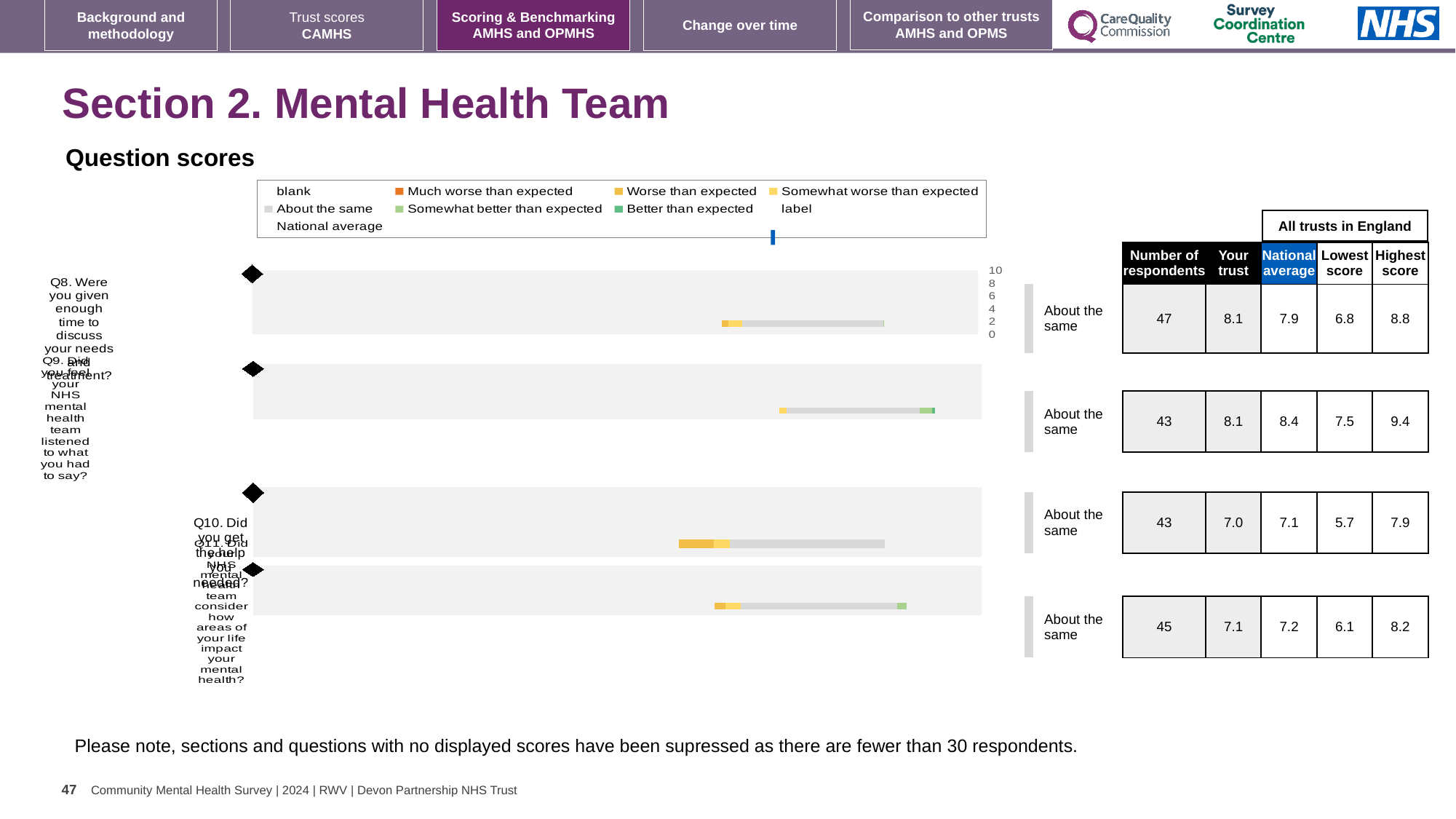
Which question has the lowest 'Your trust' score? Q10 How many respondents answered Q11 (Did your NHS mental health team consider how areas of your life impact your mental health)? 45 In the question scores chart, what colour does the legend use for 'Much worse than expected'? orange What is the 'Your trust' score for Q8 (Were you given enough time to discuss your needs and treatment)? 8.1 What kind of chart is used to show the question scores on this slide? bar chart For Q9, what is the difference between the highest score (9.4) and the lowest score (7.5) among all trusts in England? 1.9 What is the lowest score among all trusts in England for Q10 (Did you get the help you needed)? 5.7 What is the national average score for Q9 (Did you feel your NHS mental health team listened to what you had to say)? 8.4 Which question has the highest number of respondents? Q8 For Q8, which is larger: the 'Your trust' score or the national average? Your trust How many questions (Q8 to Q11) are plotted in the question scores chart? 4 Which question has the highest national average score? Q9